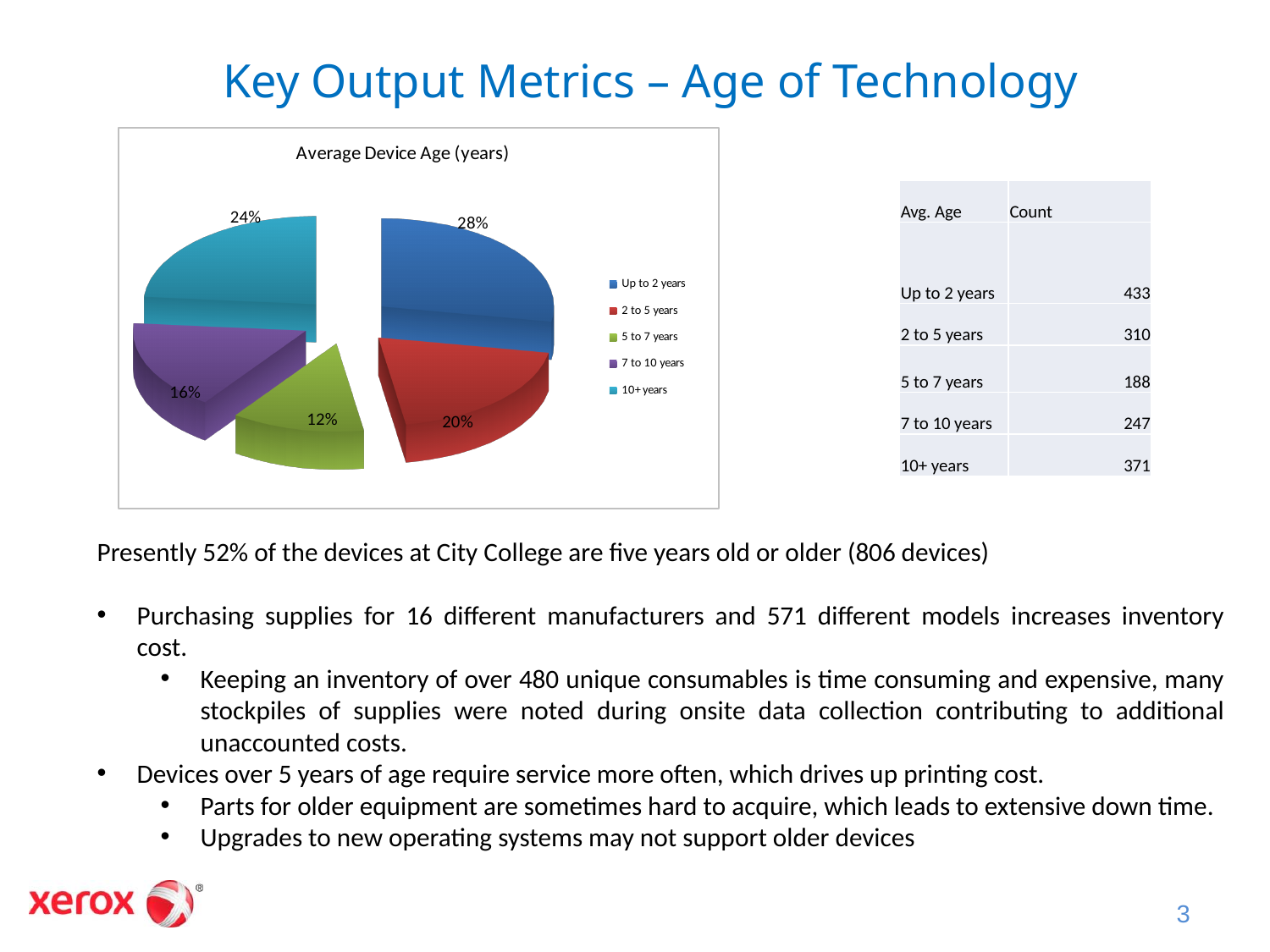
What type of chart is shown on the slide? Pie chart How many slices does the pie chart have? 5 What percentage is shown for the '10+ years' slice? 24% Which slice is larger, '10+ years' or '7 to 10 years'? 10+ years What percentage is shown for the '7 to 10 years' slice? 16% Which category has the smallest slice of the pie? 5 to 7 years What is the difference in percentage points between the 'Up to 2 years' slice and the '2 to 5 years' slice? 8 percentage points Which category has the largest slice of the pie? Up to 2 years What percentage of the pie is the 'Up to 2 years' slice? 28% What is the title of the chart? Average Device Age (years) What percentage is shown for the '2 to 5 years' slice? 20% How many entries does the chart legend list? 5